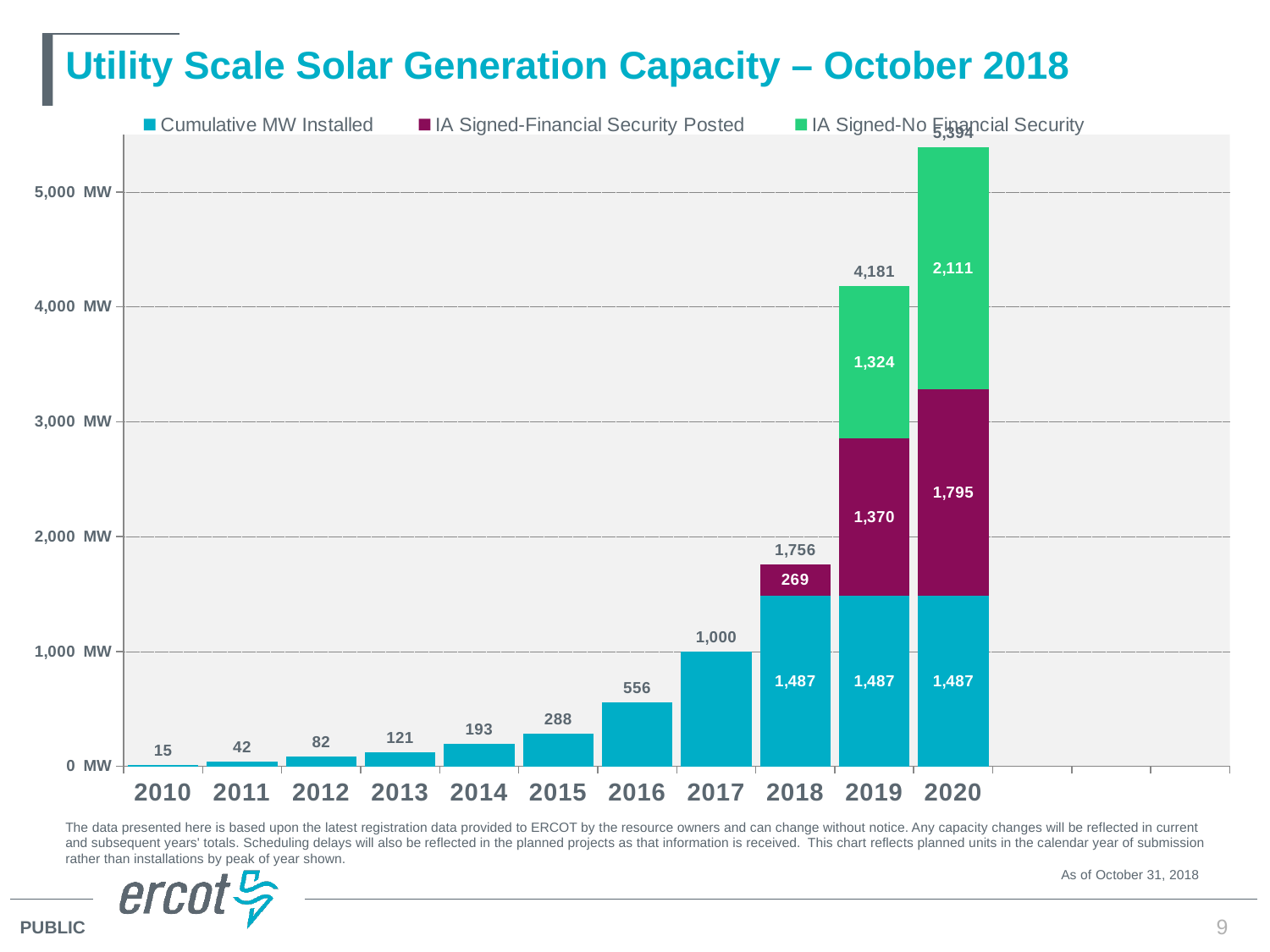
How many years are shown on the x axis? 11 Which year has the tallest stacked bar? 2020 Which is larger: the IA Signed-Financial Security Posted value for 2020 or the IA Signed-No Financial Security value for 2019? IA Signed-Financial Security Posted for 2020 How many series does the legend list? 3 Does the Cumulative MW Installed value rise or fall from 2010 to 2018? Rise What is the total labelled on top of the 2019 bar? 4,181 What is the IA Signed-Financial Security Posted value for 2019? 1,370 Which year has the lowest Cumulative MW Installed value? 2010 What type of chart is shown on the slide? Stacked bar chart What is the difference between the Cumulative MW Installed values for 2017 and 2015? 712 What is the Cumulative MW Installed value for 2016? 556 What is the IA Signed-No Financial Security value for 2020? 2,111